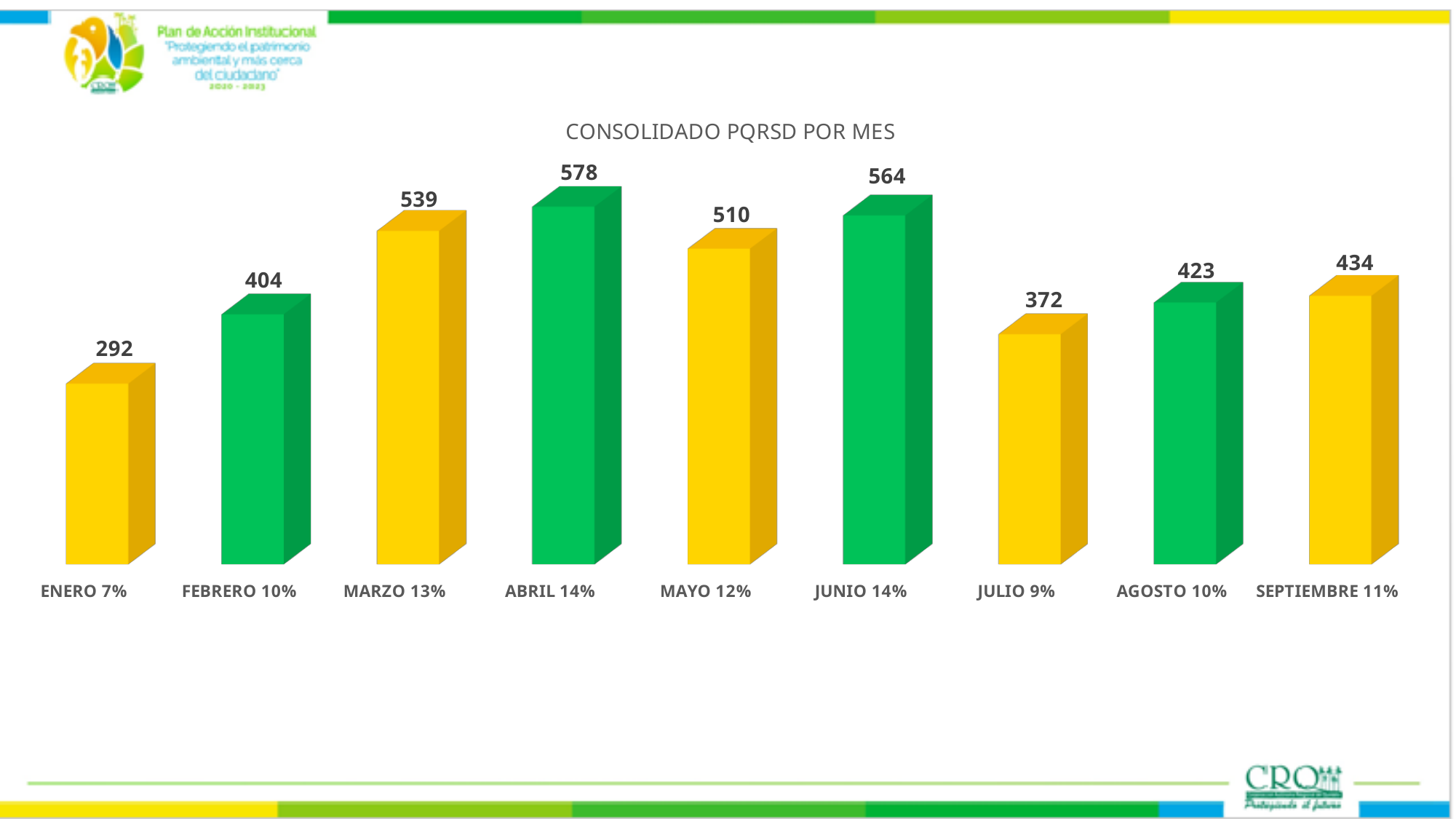
Which month has the lowest value? ENERO 7% What is the value for ABRIL 14% in the CONSOLIDADO PQRSD POR MES chart? 578 What is the title of the chart? CONSOLIDADO PQRSD POR MES What is the difference between the values for MARZO 13% and FEBRERO 10%? 135 Which is larger, the value for MAYO 12% or the value for AGOSTO 10%? MAYO 12% Which month has the highest value? ABRIL 14% Do the values rise or fall from JUNIO 14% to JULIO 9%? Fall What is the value for ENERO 7%? 292 What is the difference between the values for ABRIL 14% and JUNIO 14%? 14 How many months are shown in the chart? 9 What is the value for SEPTIEMBRE 11%? 434 What kind of chart is shown on the slide? Bar chart